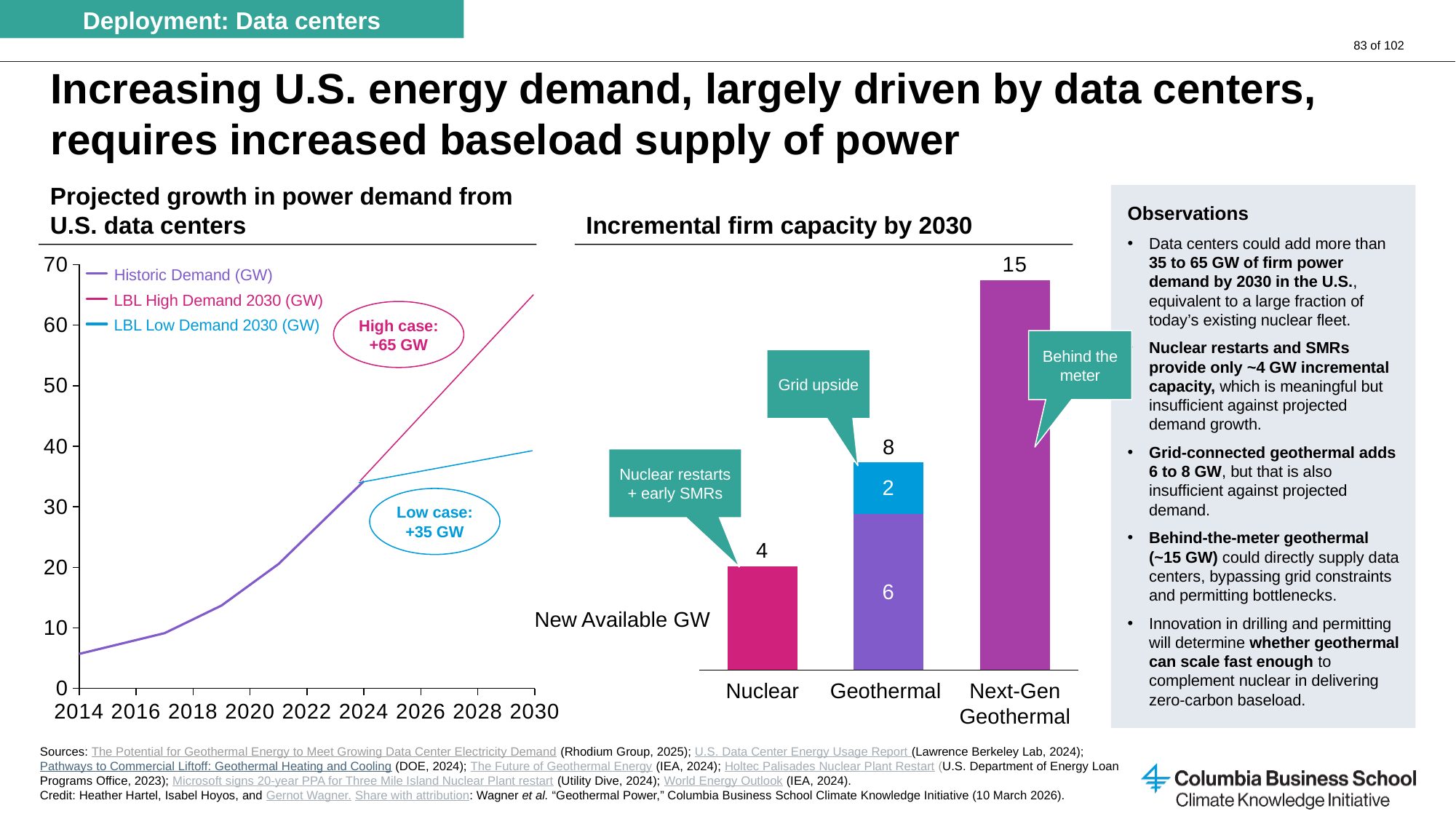
What kind of chart is 'Incremental firm capacity by 2030'? Bar chart In the 'Incremental firm capacity by 2030' chart, which category has the highest value? Next-Gen Geothermal How many series does the legend of the 'Projected growth in power demand from U.S. data centers' chart list? 3 In the 'Incremental firm capacity by 2030' chart, which category has the lowest value? Nuclear In the 'Incremental firm capacity by 2030' chart, how many categories are shown on the x axis? 3 In the 'Projected growth in power demand from U.S. data centers' chart, does the Historic Demand (GW) line rise or fall from 2014 to 2024? Rise In the 'Incremental firm capacity by 2030' chart, what is the value labeled for Nuclear? 4 In the 'Incremental firm capacity by 2030' chart, what is the value for Next-Gen Geothermal? 15 In the 'Incremental firm capacity by 2030' chart, what is the total labeled above the Geothermal bar? 8 In the 'Projected growth in power demand from U.S. data centers' chart, is the LBL High Demand 2030 value in 2030 greater or less than 60? greater In the 'Incremental firm capacity by 2030' chart, what is the difference between the Next-Gen Geothermal value and the Nuclear value? 11 In the 'Incremental firm capacity by 2030' chart, what is the value of the 'Grid upside' segment of the Geothermal bar? 2